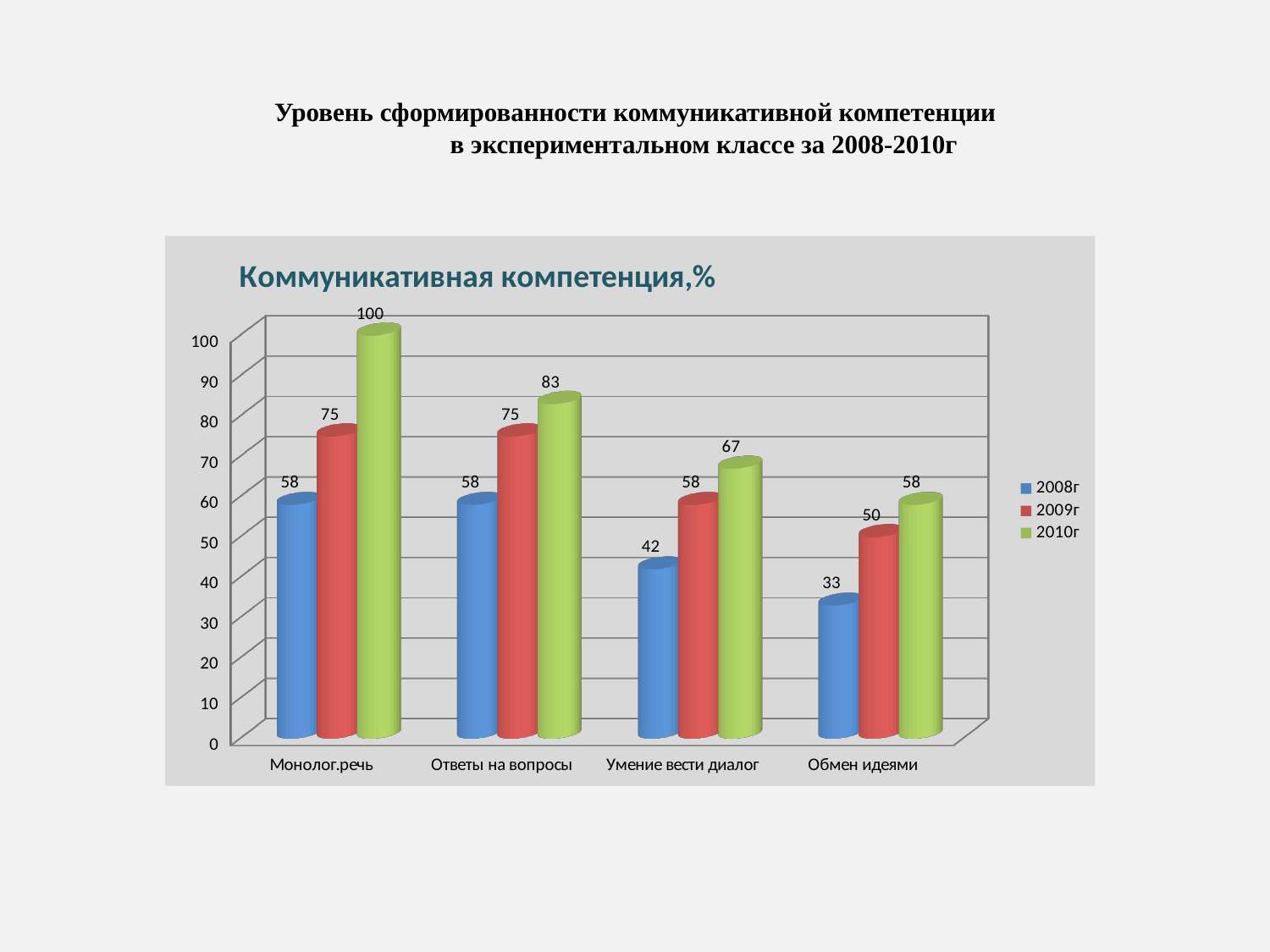
What is the title of the chart? Коммуникативная компетенция,% What is the value for 2010г in the Монолог.речь category? 100 Do the values for Умение вести диалог rise or fall from 2008г to 2010г? Rise Which category has the highest value for 2010г? Монолог.речь What is the value for 2008г in the Обмен идеями category? 33 Which is larger: the 2009г value for Обмен идеями or the 2009г value for Монолог.речь? Монолог.речь What is the value for 2009г in the Умение вести диалог category? 58 How many categories are shown on the x axis? 4 What is the difference between the 2010г and 2008г values for Ответы на вопросы? 25 Which category has the lowest value for 2008г? Обмен идеями What kind of chart is shown? Bar chart How many series does the legend list? 3